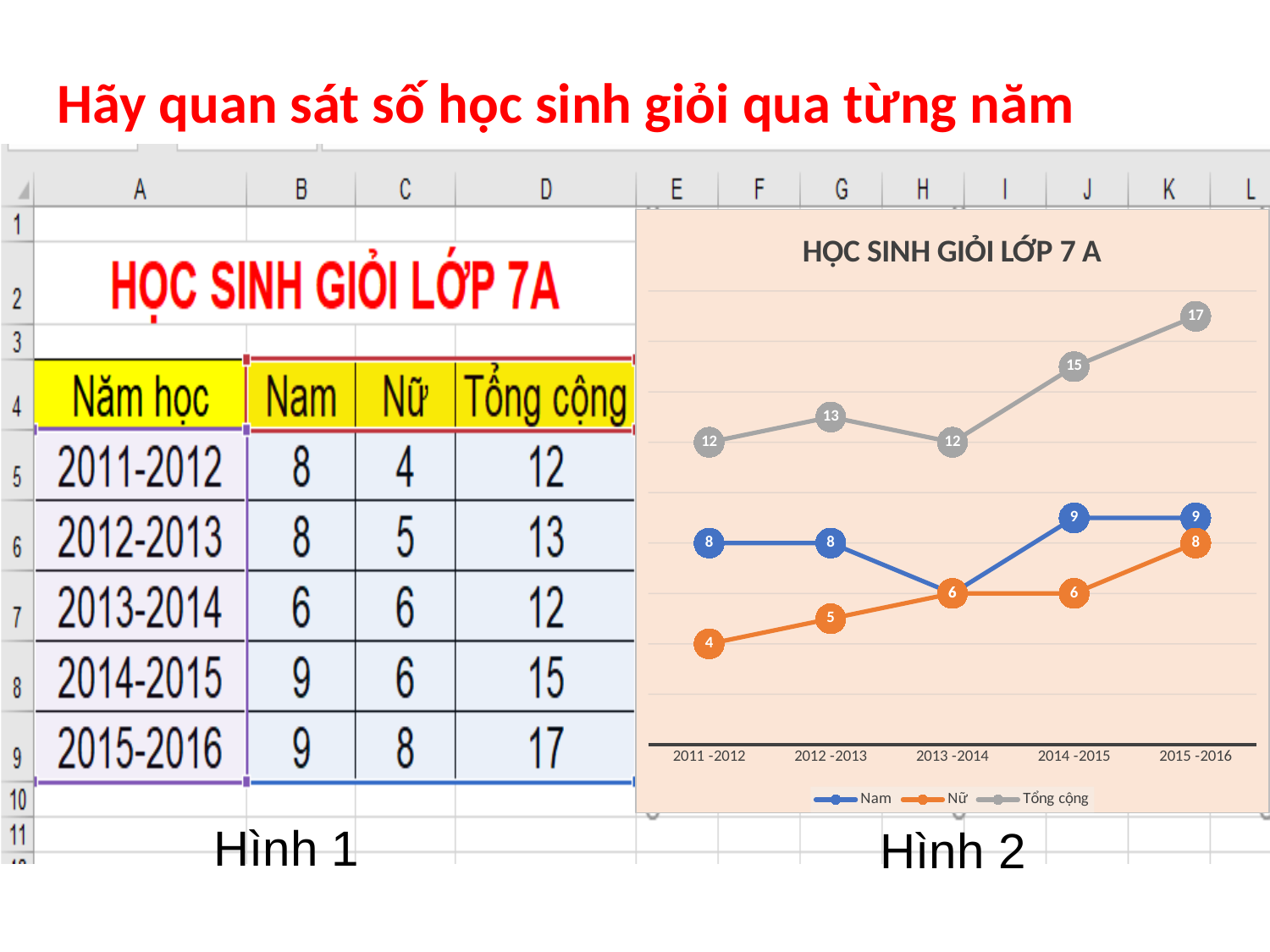
What is the value of Nữ for 2011-2012 in the chart? 4 What is the value of Tổng cộng for 2014-2015 in the chart? 15 Does the Nữ series rise or fall from 2011-2012 to 2015-2016 in the chart? rise What kind of chart is shown in Hình 2? line chart What is the title of the chart in Hình 2? HỌC SINH GIỎI LỚP 7 A Which is larger for 2015-2016 in the chart, Nam or Nữ? Nam What is the difference between Nam and Nữ for 2011-2012 in the chart? 4 How many school years are plotted along the x axis of the chart? 5 In which school year is Tổng cộng highest in the chart? 2015-2016 What is the value of Nam for 2013-2014 in the chart? 6 In which school year is Nữ lowest in the chart? 2011-2012 How many series does the legend of the chart list? 3